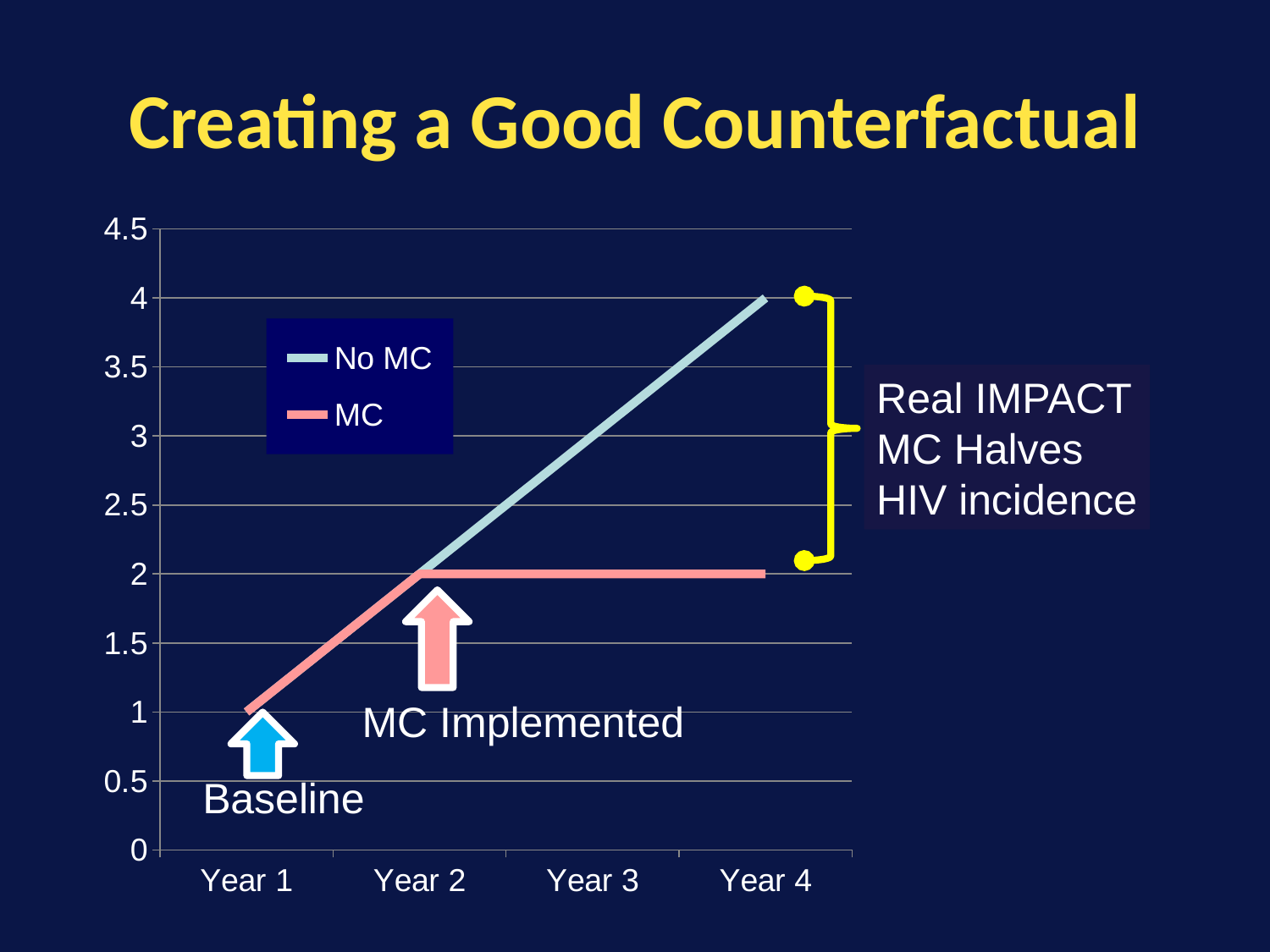
Is the value of the No MC series at Year 3 greater or less than 2.5? greater What kind of chart is shown on the slide? line chart How many years are shown on the x axis? 4 What is the value of the MC series at Year 4? 2 What is the value of the No MC series at Year 2? 2 What is the title of the slide containing the chart? Creating a Good Counterfactual How many series does the legend list? 2 Which series has the higher value at Year 4, No MC or MC? No MC What is the value of the No MC series at Year 4? 4 Does the No MC series rise or fall from Year 1 to Year 4? rise What is the difference between the No MC and MC values at Year 4? 2 What is the value of the MC series at Year 1? 1